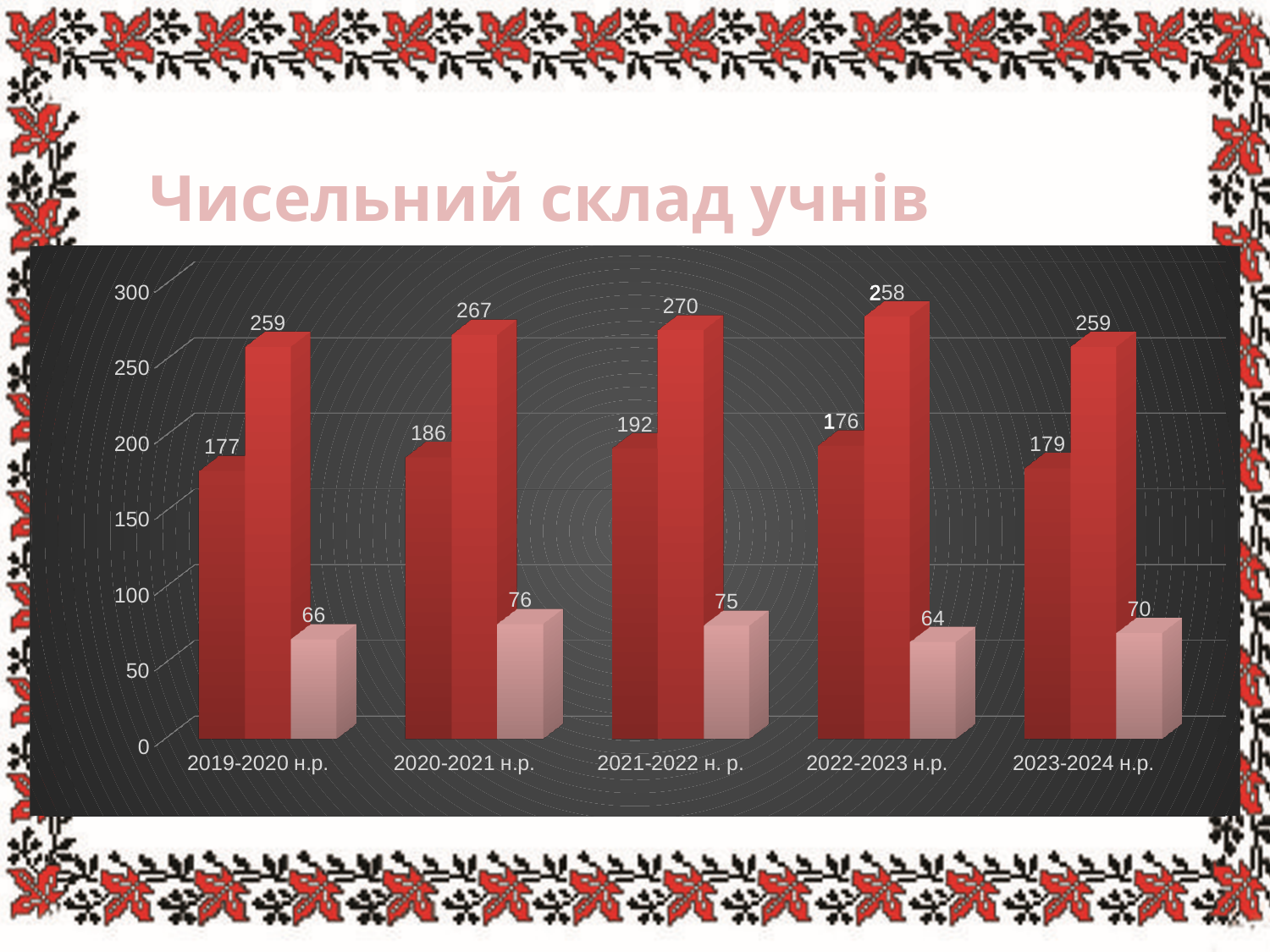
Does the bright red (middle) bar rise or fall from 2019-2020 н.р. to 2021-2022 н. р.? rise What is the value of the dark red (first) bar for 2023-2024 н.р.? 179 What type of chart is shown on the slide? bar chart What is the title of the chart? Чисельний склад учнів How many school-year categories are shown on the x axis? 5 In which school year is the light pink (third) bar the lowest? 2022-2023 н.р. What is the value of the tallest (bright red) bar for 2021-2022 н. р.? 270 What is the value of the light pink bar for 2020-2021 н.р.? 76 Is the value of the light pink bar for 2023-2024 н.р. greater or less than 100? less What is the difference between the bright red bar and the dark red bar for 2019-2020 н.р.? 82